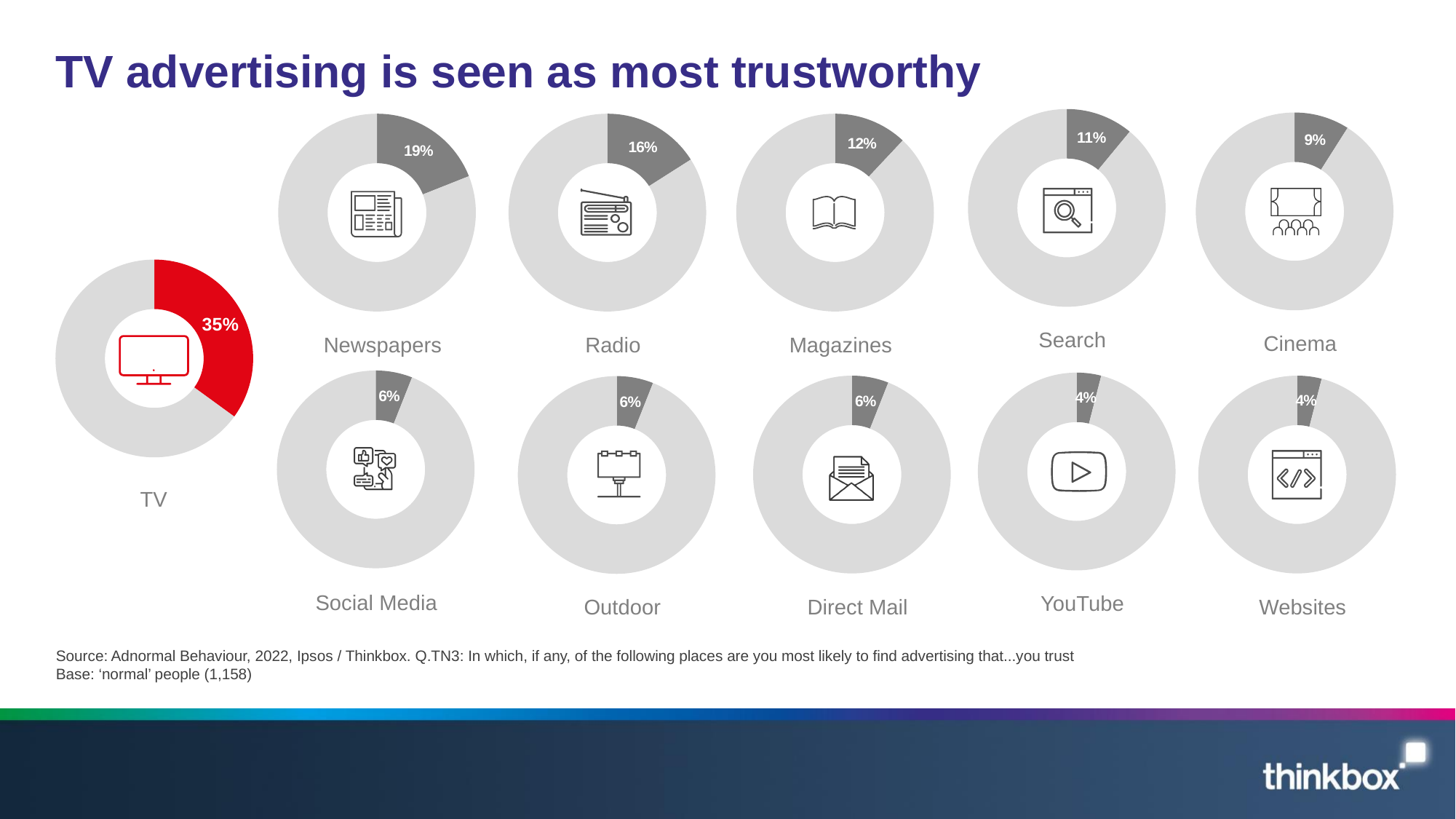
Which has a higher percentage, Cinema or YouTube? Cinema What kind of chart is used for each medium on the slide? Donut (pie) chart What percentage is shown for Newspapers? 19% What is the difference in percentage points between Magazines and Search? 1 Which medium has the highest percentage on the slide? TV How many media categories are shown on the slide? 11 What percentage is shown for Cinema? 9% Which medium's chart is highlighted in red? TV Which has a higher percentage, Radio or Magazines? Radio What percentage is shown for Radio? 16% What percentage is shown for TV? 35% What is the difference in percentage points between TV and Newspapers? 16